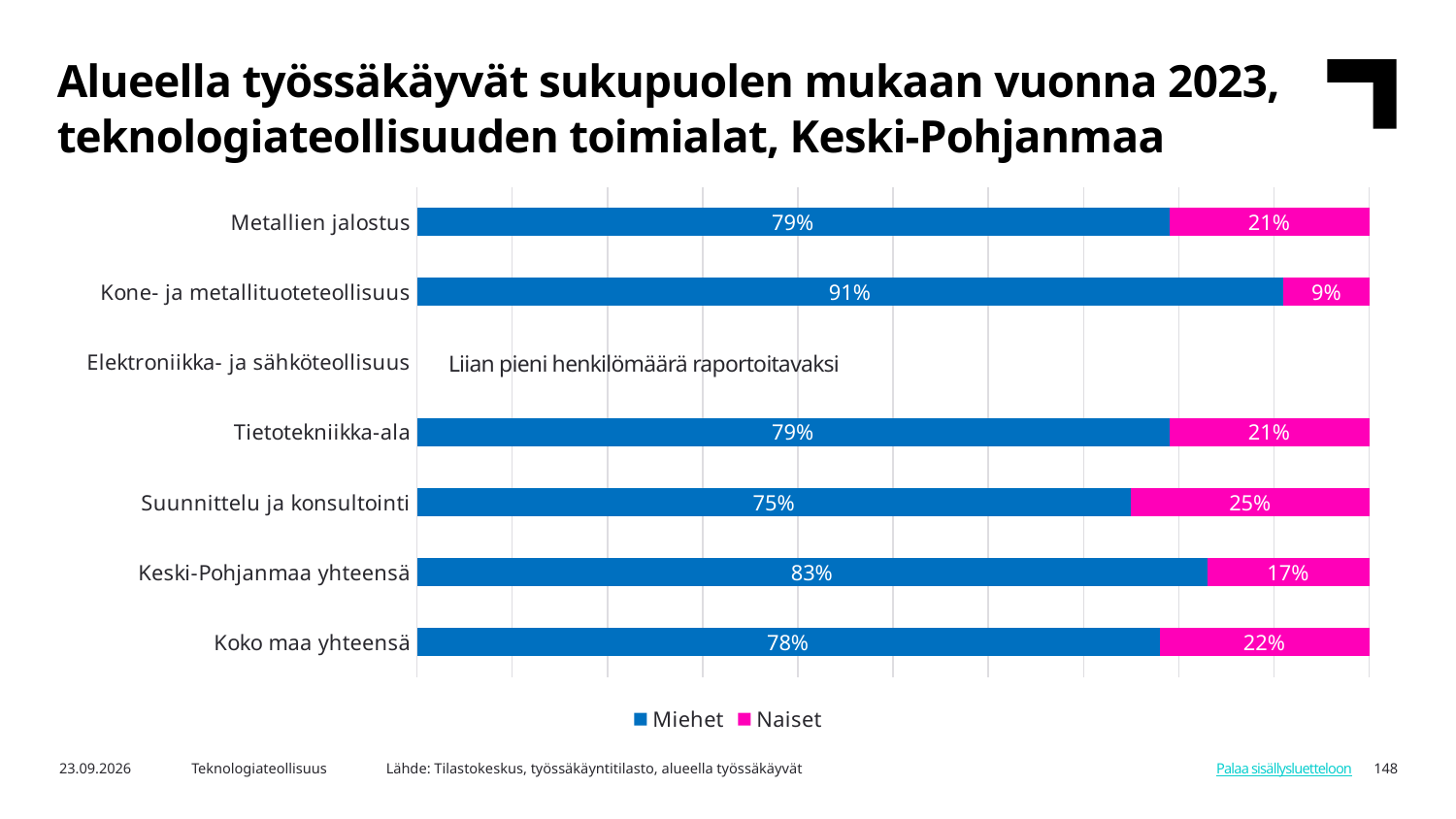
How many series does the legend list? 2 What is the Miehet share for Koko maa yhteensä? 78% What is the Naiset share for Suunnittelu ja konsultointi? 25% What kind of chart is shown on the slide? Stacked bar chart What is the total of the stacked bar for Tietotekniikka-ala? 100% What is the Naiset share for Keski-Pohjanmaa yhteensä? 17% Which is larger: the Miehet share for Keski-Pohjanmaa yhteensä or for Koko maa yhteensä? Keski-Pohjanmaa yhteensä What is the Miehet share for Kone- ja metallituoteteollisuus? 91% Which category has the highest Miehet share? Kone- ja metallituoteteollisuus What text is shown instead of a bar for Elektroniikka- ja sähköteollisuus? Liian pieni henkilömäärä raportoitavaksi Which category has the lowest Naiset share? Kone- ja metallituoteteollisuus What is the difference in Naiset share between Suunnittelu ja konsultointi and Kone- ja metallituoteteollisuus? 16 percentage points